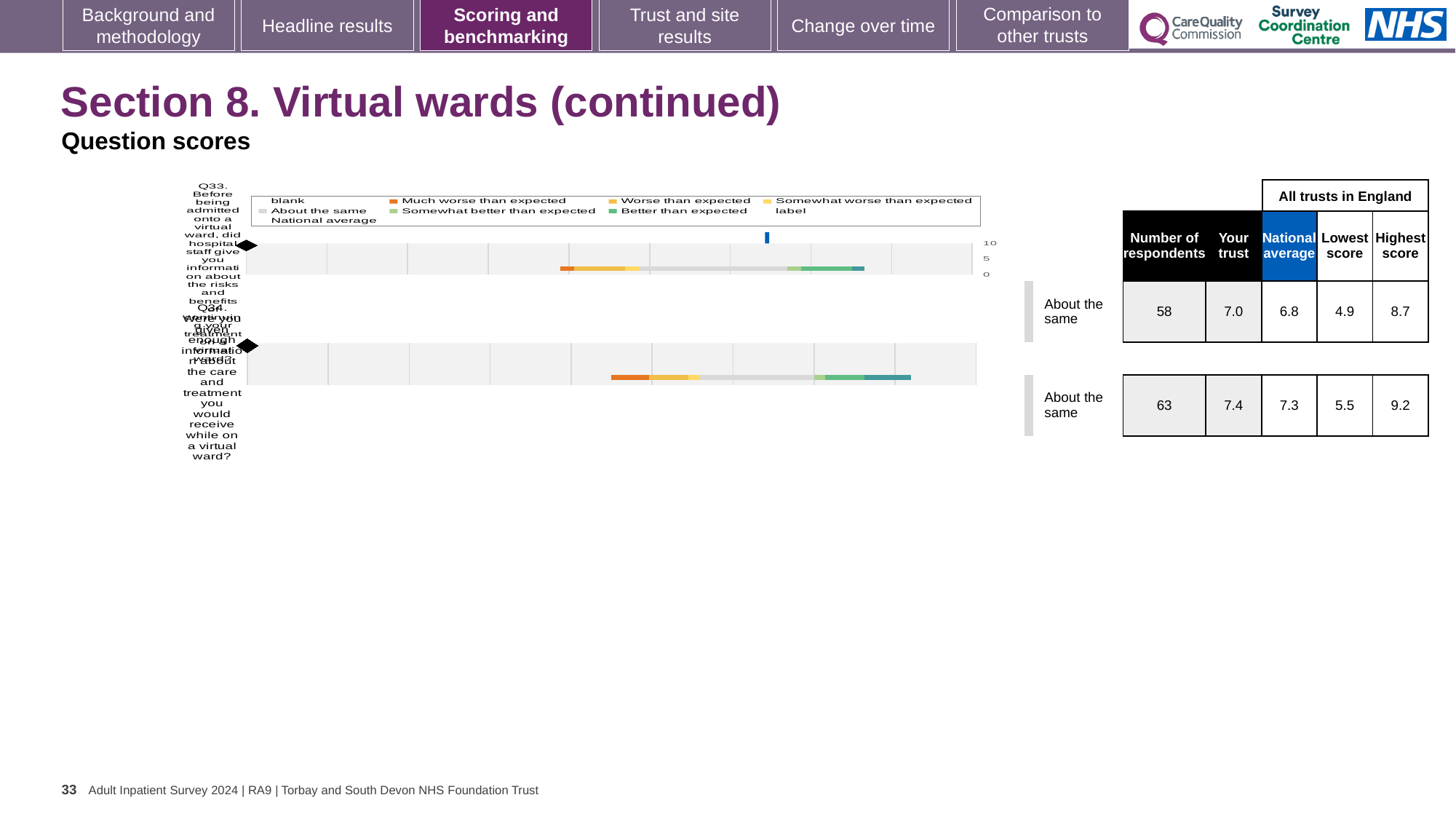
What is the difference between the highest and lowest scores for Q34 in the table? 3.7 In the table next to the chart, what is the 'Your trust' score for Q34? 7.4 What benchmark category is shown beside the chart for Q33? About the same In the table next to the chart, how many respondents answered Q33? 58 How many questions (bars) are plotted in the chart? 2 In the table next to the chart, what is the highest score among all trusts in England for Q34? 9.2 Which legend entry in the chart is shown in orange? Much worse than expected Which question has more respondents in the table, Q33 or Q34? Q34 In the table next to the chart, what is the national average for Q33? 6.8 In the table next to the chart, what is the lowest score among all trusts in England for Q33? 4.9 What kind of chart is shown on the slide? bar chart What is the difference between the 'Your trust' score and the national average for Q33 in the table? 0.2